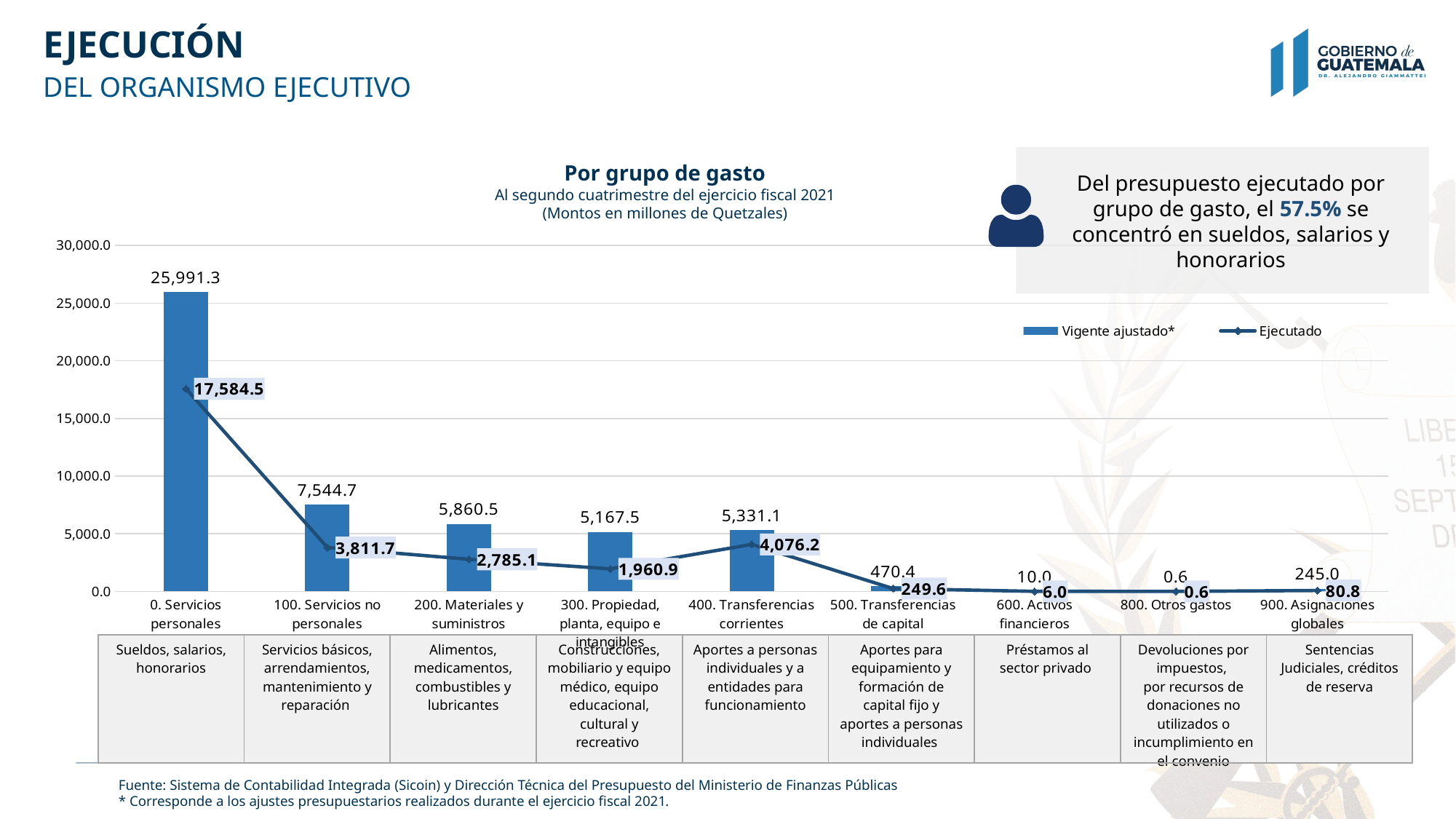
What is the difference between the Vigente ajustado* and Ejecutado values for 400. Transferencias corrientes? 1,254.9 What is the Ejecutado value for 400. Transferencias corrientes? 4,076.2 Which category has the highest Ejecutado value? 0. Servicios personales How many expense group categories are shown on the x axis? 9 What is the difference between the Vigente ajustado* and Ejecutado values for 0. Servicios personales? 8,406.8 What is the Vigente ajustado* value for 0. Servicios personales? 25,991.3 Which category has the lowest Vigente ajustado* value? 800. Otros gastos Which is larger, the Vigente ajustado* value for 200. Materiales y suministros or for 400. Transferencias corrientes? 200. Materiales y suministros What is the Vigente ajustado* value for 900. Asignaciones globales? 245.0 What is the Ejecutado value for 100. Servicios no personales? 3,811.7 How many series does the legend list? 2 What is the subtitle text below the chart title 'Por grupo de gasto' that states the units? (Montos en millones de Quetzales)